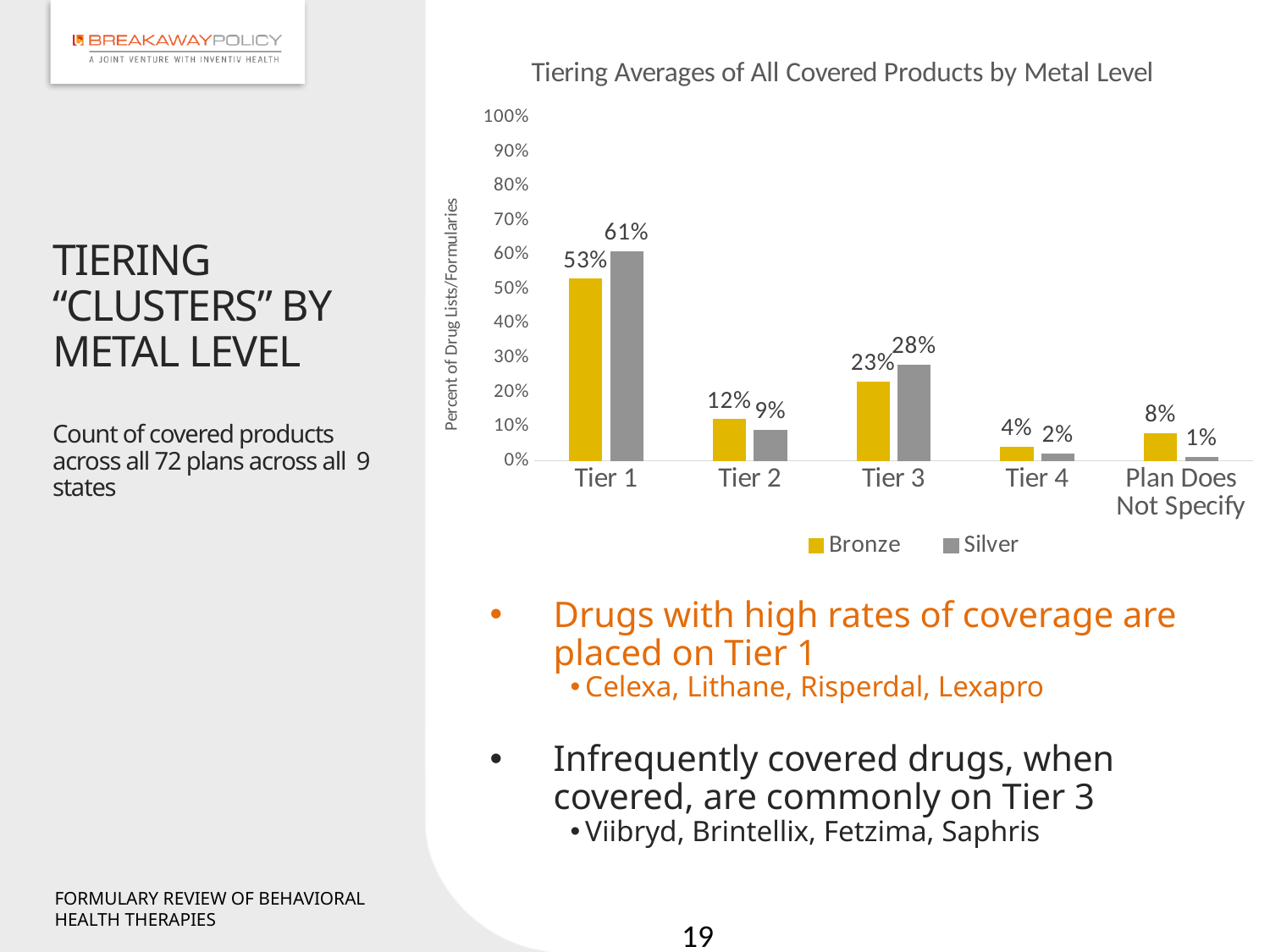
What is the Silver value for Plan Does Not Specify? 1% What kind of chart is shown on the slide? Bar chart What is the Silver value for Tier 3? 28% How many categories are shown on the x axis? 5 What is the title of the chart? Tiering Averages of All Covered Products by Metal Level Which category has the lowest Bronze value? Tier 4 For Tier 2, which series has the larger value, Bronze or Silver? Bronze What is the Bronze value for Tier 1? 53% How many series does the legend list? 2 Is the Bronze value for Tier 3 greater or less than 30%? less What is the difference between the Silver and Bronze values for Tier 1? 8% Which tier category has the highest Silver value? Tier 1